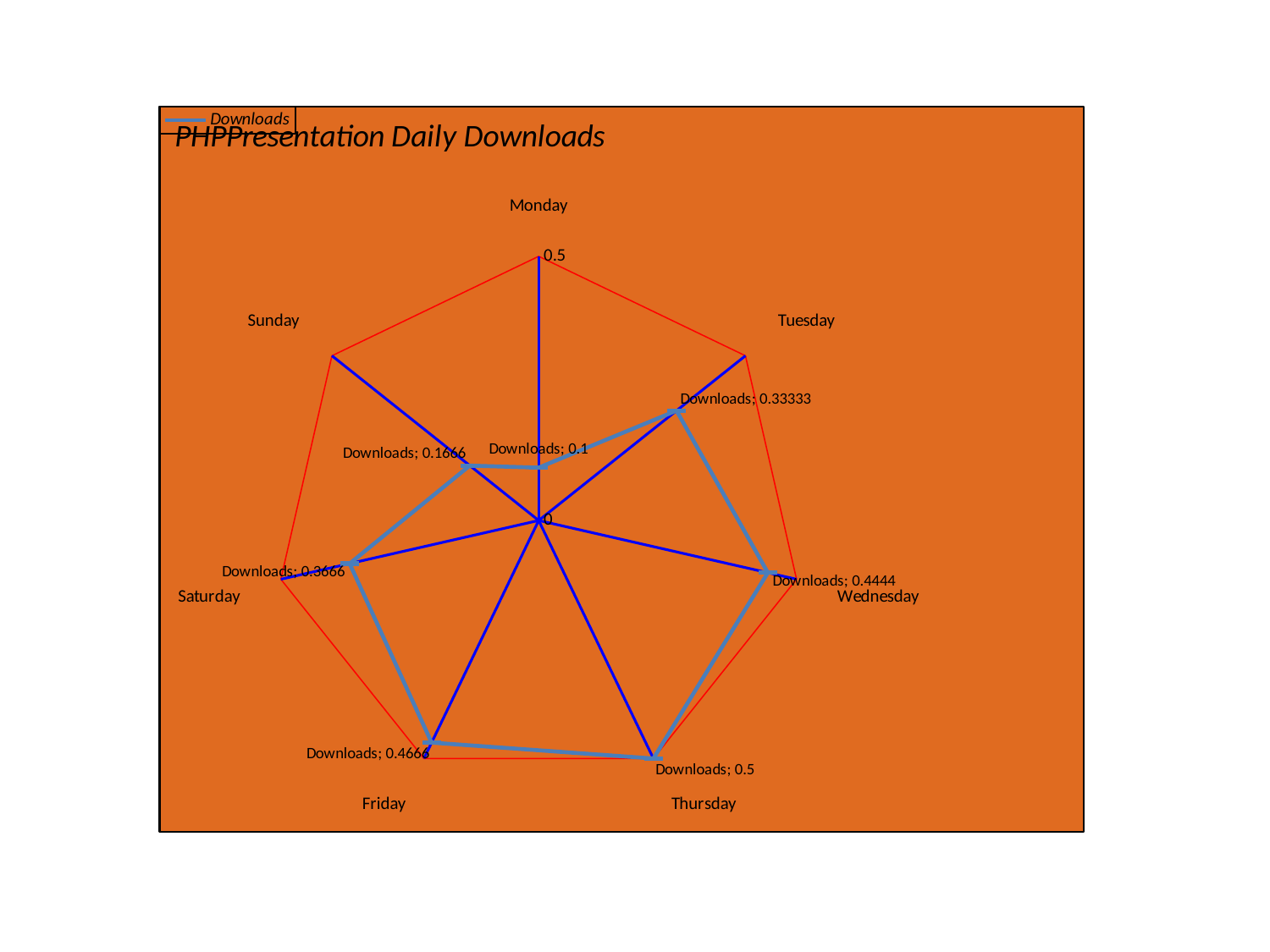
What is the difference between the Downloads values for Thursday and Monday? 0.4 What is the Downloads value for Sunday? 0.1666 Which day has the lowest Downloads value? Monday What type of chart is shown on the slide? Radar chart Is the Downloads value for Friday greater or less than 0.5? less How many categories (days) are plotted on the chart? 7 How many series does the legend list? 1 What is the Downloads value for Wednesday? 0.4444 What is the title of the chart? PHPPresentation Daily Downloads What is the Downloads value for Tuesday? 0.33333 Which day has the highest Downloads value? Thursday What is the Downloads value for Monday? 0.1